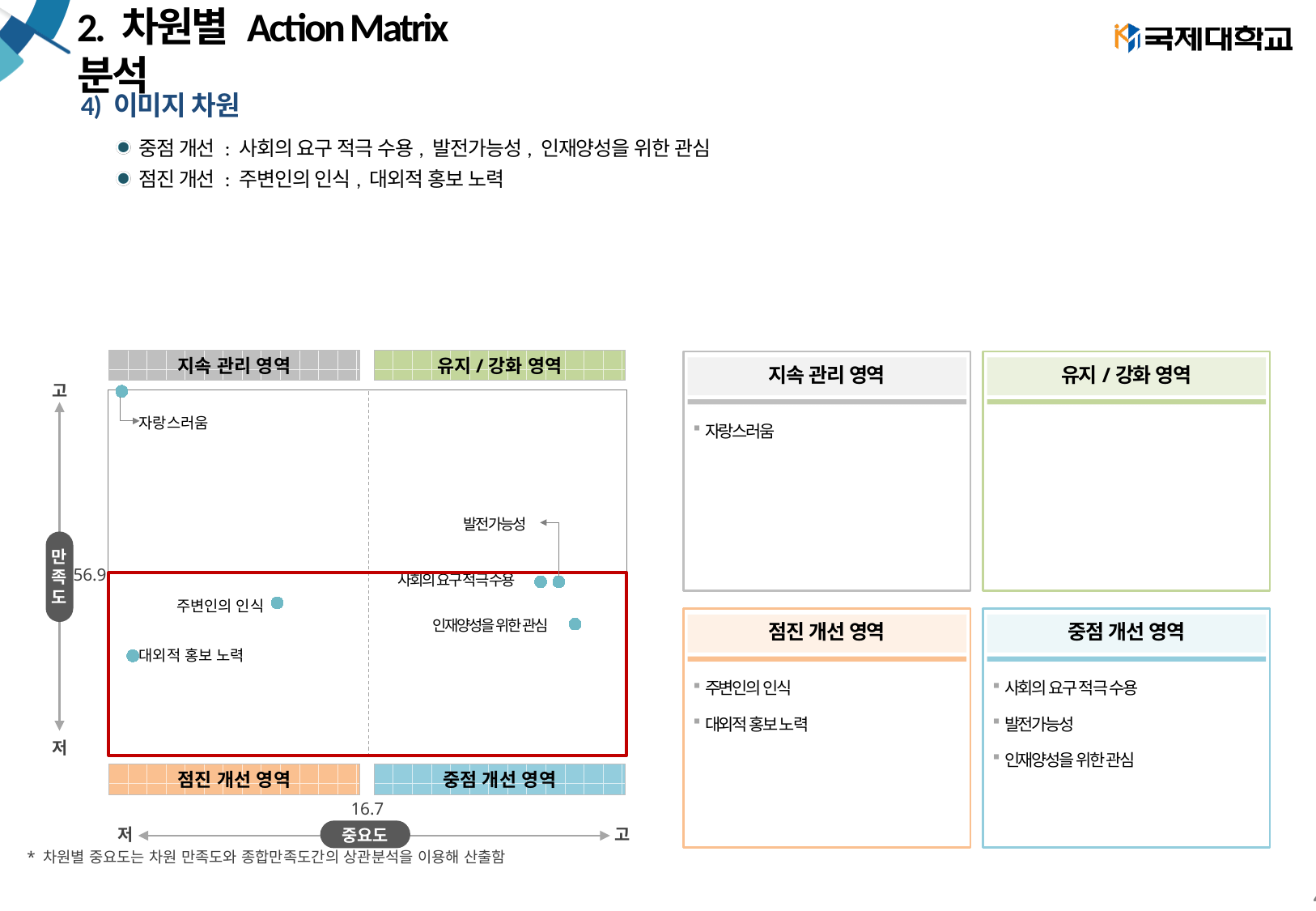
Is the satisfaction value for 자랑스러움 greater or less than 56.9? greater What importance value marks the vertical reference line in the action matrix? 16.7 Which item has the highest satisfaction (만족도) in the action matrix? 자랑스러움 Which quadrant of the action matrix contains 자랑스러움? 지속 관리 영역 Is the importance value for 인재양성을 위한 관심 greater or less than 16.7? greater How many data points are plotted in the action matrix? 6 What kind of chart is the action matrix on the left of the slide? scatter plot Which item has the lowest satisfaction (만족도) in the action matrix? 대외적 홍보 노력 What satisfaction value marks the horizontal reference line in the action matrix? 56.9 Which has higher satisfaction, 자랑스러움 or 대외적 홍보 노력? 자랑스러움 Is the satisfaction value for 주변인의 인식 greater or less than 56.9? less Which has higher importance (중요도), 사회의 요구 적극 수용 or 주변인의 인식? 사회의 요구 적극 수용